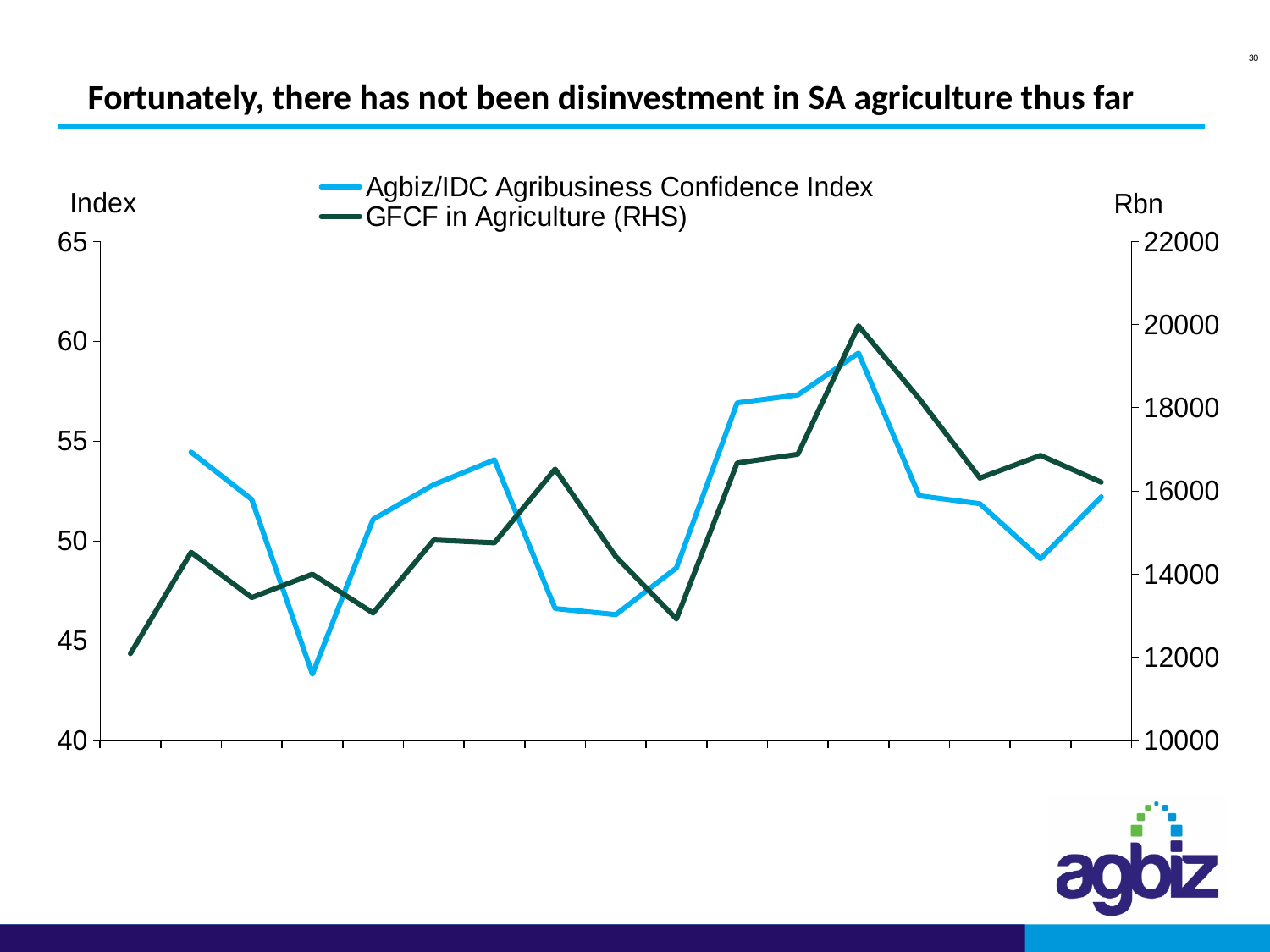
What is the label of the right-hand vertical axis? Rbn What kind of chart is shown on the slide? line chart What is the maximum value shown on the left-hand vertical axis? 65 Which series is plotted on the right-hand axis (RHS)? GFCF in Agriculture Is the highest value of the GFCF in Agriculture line greater or less than 18000? greater How many series does the legend list? 2 Is the highest value of the Agbiz/IDC Agribusiness Confidence Index greater or less than 60? less Is the first plotted value of the Agbiz/IDC Agribusiness Confidence Index greater or less than 50? greater Overall, does the GFCF in Agriculture line rise or fall from the left of the chart to the right? rise